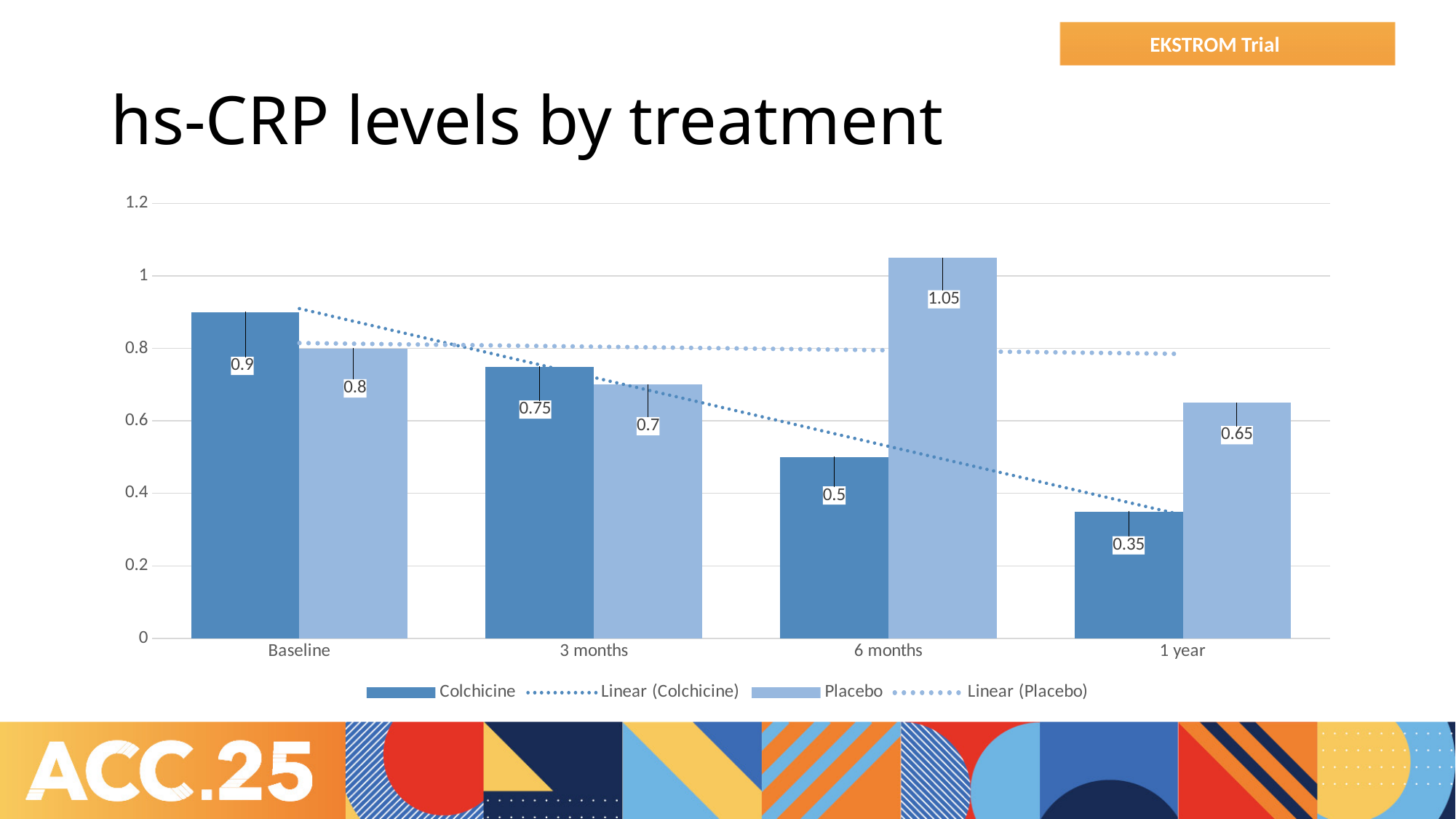
At which time point is the Colchicine value lowest? 1 year How many time points are shown on the x axis? 4 How many entries does the legend list? 4 Do the Colchicine values rise or fall from Baseline to 1 year? Fall What is the hs-CRP value for Placebo at 6 months? 1.05 What kind of chart is shown on the slide? Bar chart What is the hs-CRP value for Colchicine at 1 year? 0.35 What is the hs-CRP value for Colchicine at Baseline? 0.9 At which time point is the Placebo value highest? 6 months Which is larger at 1 year, the Colchicine value or the Placebo value? Placebo What is the difference between the Placebo and Colchicine values at 6 months? 0.55 What is the hs-CRP value for Placebo at 3 months? 0.7